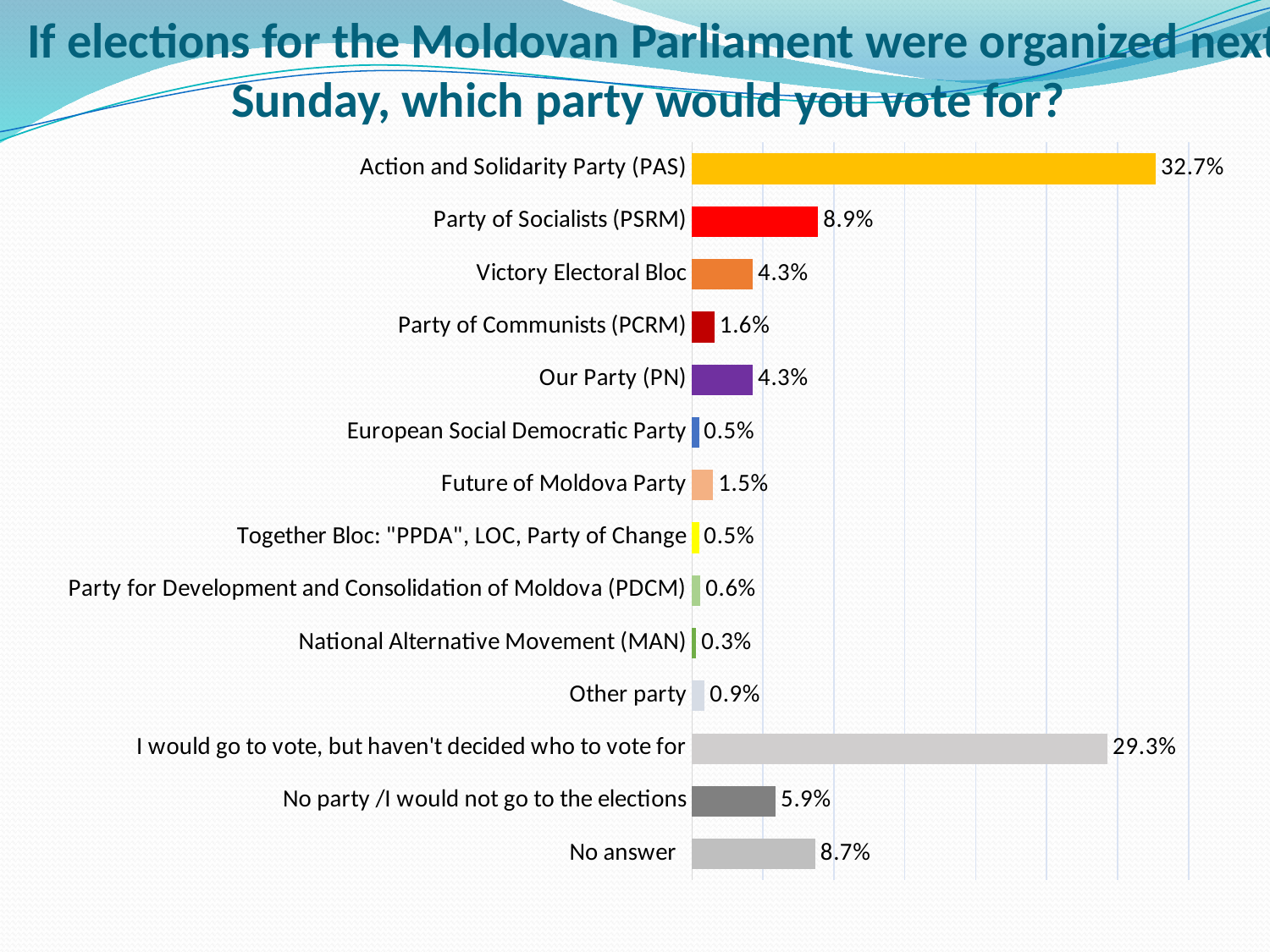
What percentage is shown for the Party of Socialists (PSRM)? 8.9% What is the difference between the value for Action and Solidarity Party (PAS) and the value for 'I would go to vote, but haven't decided who to vote for'? 3.4% What percentage of respondents would vote for the Action and Solidarity Party (PAS)? 32.7% What is the value for 'No party /I would not go to the elections'? 5.9% How many categories are shown in the chart? 14 Which is larger: the value for Party of Communists (PCRM) or the value for Future of Moldova Party? Party of Communists (PCRM) What is the title of the chart on the slide? If elections for the Moldovan Parliament were organized next Sunday, which party would you vote for? Which category has the lowest value in the chart? National Alternative Movement (MAN) Which category has the highest value in the chart? Action and Solidarity Party (PAS) What is the value for 'I would go to vote, but haven't decided who to vote for'? 29.3% What is the difference between the values for Party of Socialists (PSRM) and Victory Electoral Bloc? 4.6% What kind of chart is shown on the slide? bar chart